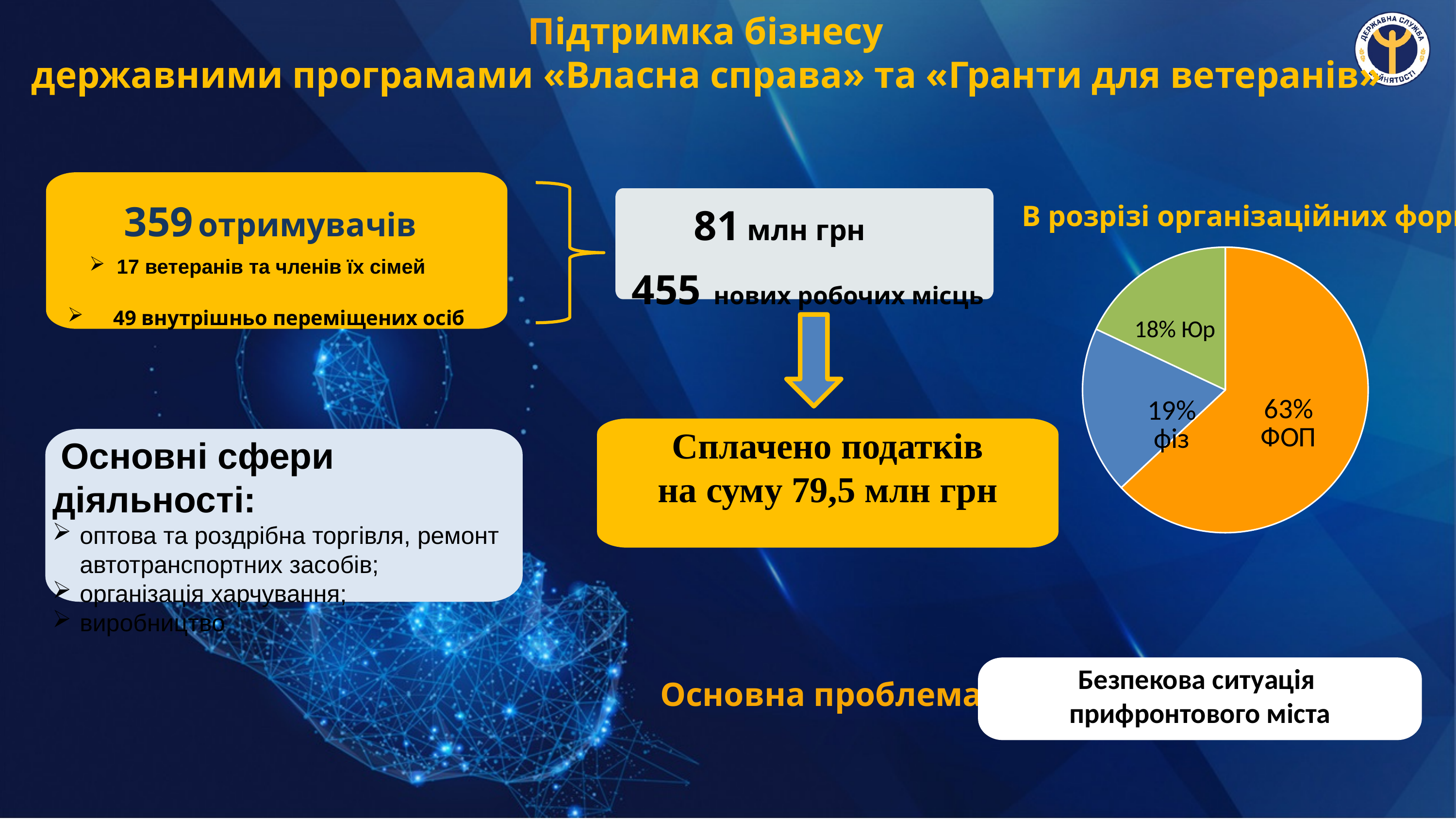
What share of the pie chart is labelled фіз? 19% What is the difference in percentage points between the ФОП slice and the фіз slice? 44 Which category has the largest slice in the pie chart? ФОП What colour is the ФОП slice in the pie chart? orange Which slice is larger, ФОП or Юр? ФОП What share of the pie chart is labelled ФОП? 63% What share of the pie chart is labelled Юр? 18% Which category has the smallest slice in the pie chart? Юр What kind of chart is shown on the slide? pie chart What is the difference in percentage points between the фіз slice and the Юр slice? 1 What colour is the Юр slice in the pie chart? green How many slices does the pie chart have? 3